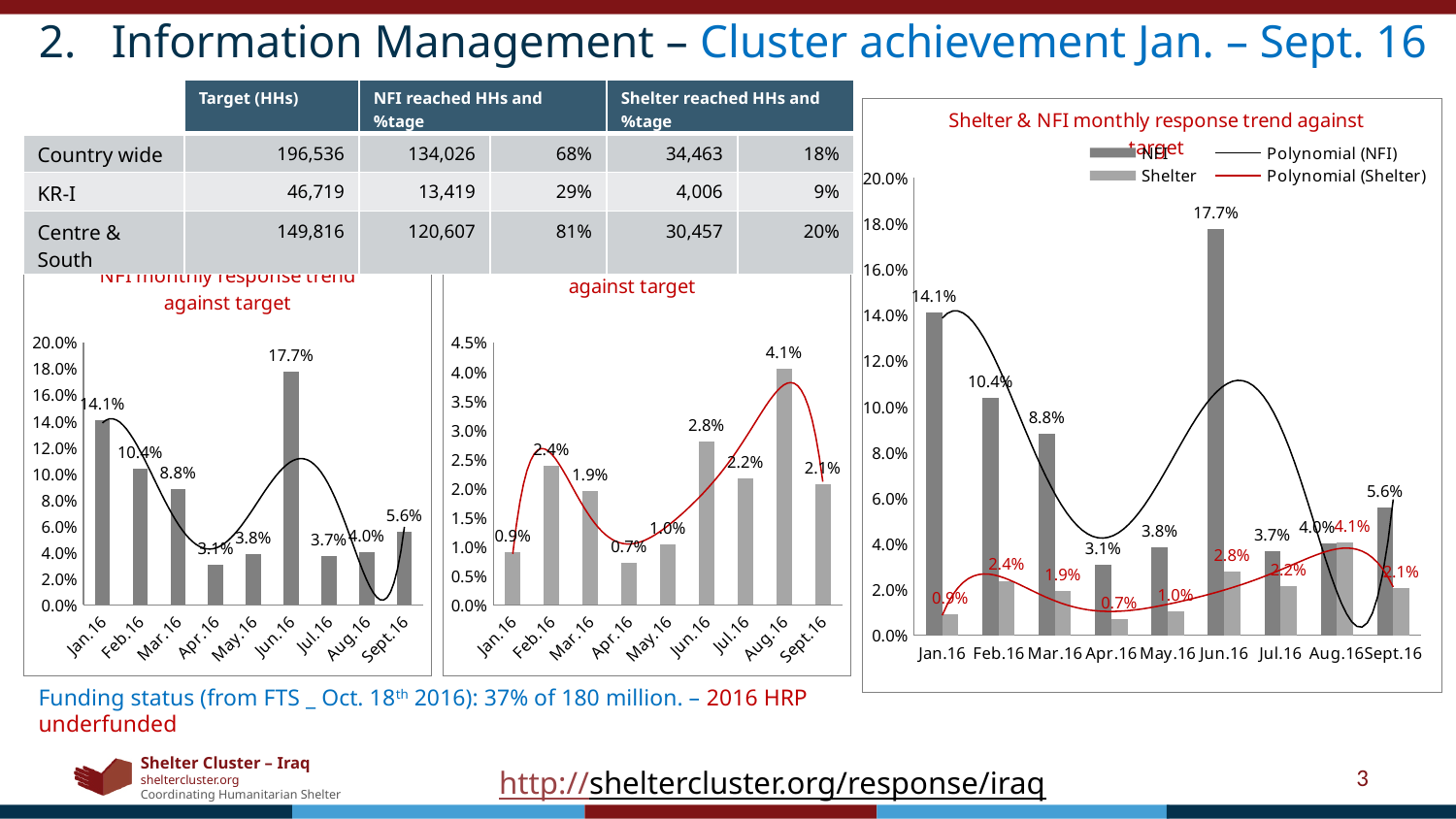
In the 'NFI monthly response trend against target' chart, which month has the lowest value? Apr.16 In the 'NFI monthly response trend against target' chart, how many months are plotted? 9 In the middle chart (Shelter monthly response against target), which month has the lowest value? Apr.16 In the 'NFI monthly response trend against target' chart, what is the value for Jun.16? 17.7% In the middle chart (Shelter monthly response against target), what is the value for Aug.16? 4.1% In the 'NFI monthly response trend against target' chart, what is the difference between the Jan.16 and Feb.16 values? 3.7% In the 'Shelter & NFI monthly response trend against target' chart, what is the Shelter value for Feb.16? 2.4% In the 'NFI monthly response trend against target' chart, which month has the highest value? Jun.16 In the 'Shelter & NFI monthly response trend against target' chart, how many entries does the legend list? 4 In the middle chart (Shelter monthly response against target), is the value for Jun.16 greater or less than 2.5%? greater What type of chart is the 'Shelter & NFI monthly response trend against target' chart? Bar chart with trend lines In the 'Shelter & NFI monthly response trend against target' chart, which is larger for Sept.16, the NFI value or the Shelter value? NFI